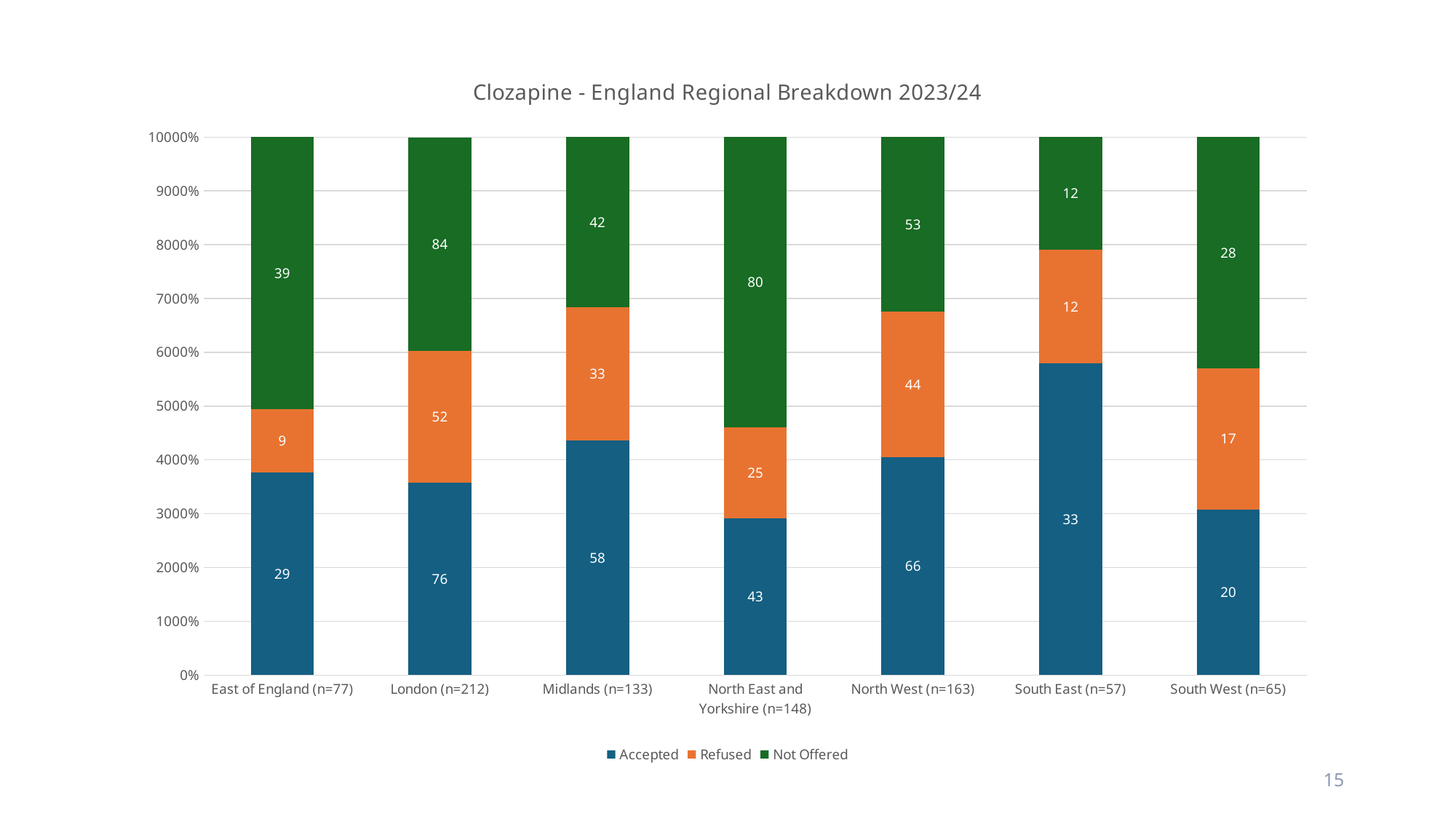
What is the total of the three data labels in the South East (n=57) bar? 57 What is the Refused value for South West (n=65)? 17 Which region has the lowest Refused value? East of England (n=77) How many series does the legend list? 3 What is the title of the chart? Clozapine - England Regional Breakdown 2023/24 What is the Accepted value for London (n=212)? 76 What kind of chart is shown on the slide? Stacked bar chart How many regions are shown on the x axis? 7 What is the difference between the Not Offered values for London (n=212) and Midlands (n=133)? 42 What is the Not Offered value for North East and Yorkshire (n=148)? 80